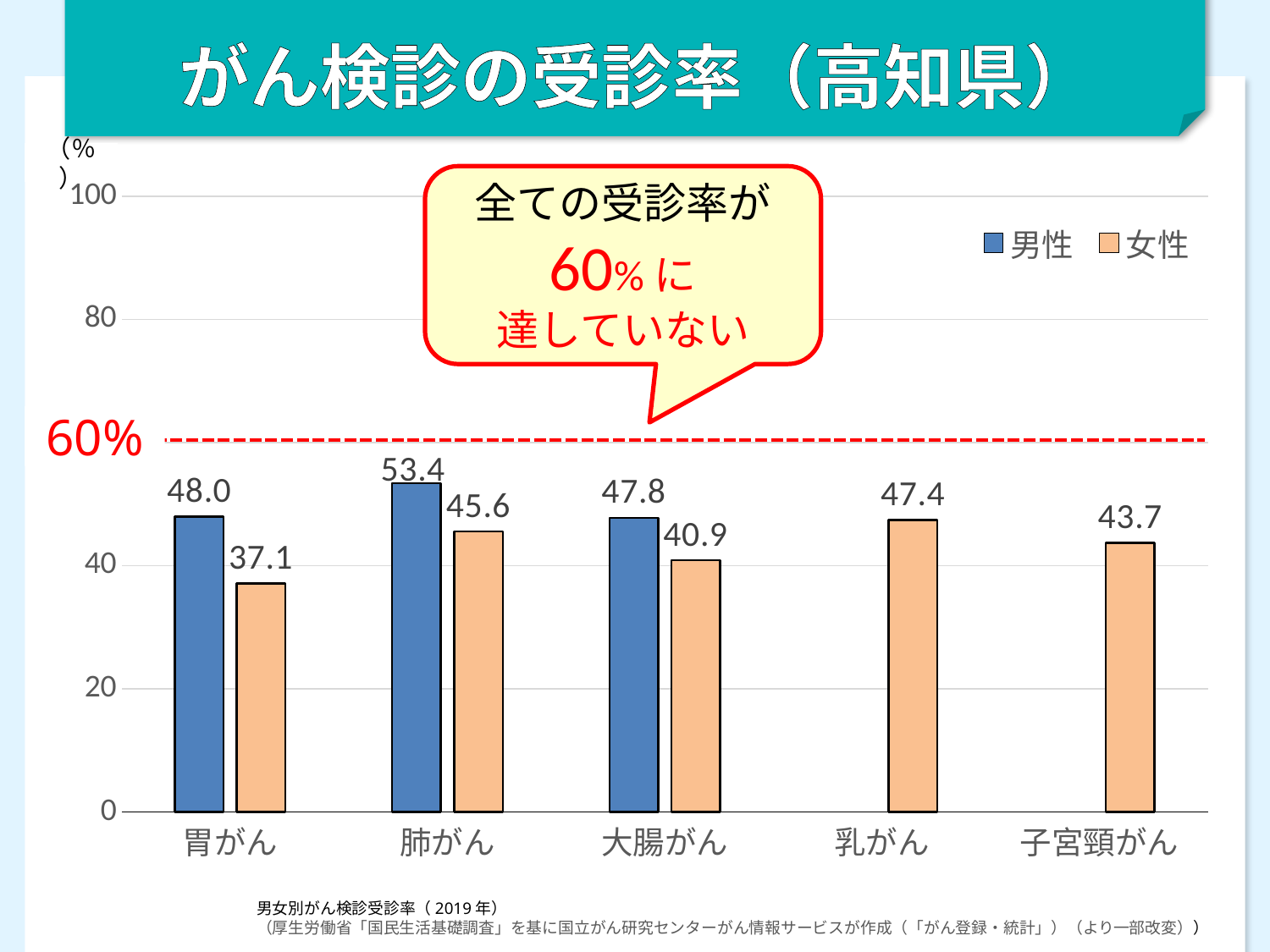
What is the screening rate for 男性 in the 胃がん category? 48.0 How many categories are shown on the x axis? 5 What is the value for 女性 in the 乳がん category? 47.4 What is the difference between the 男性 and 女性 values for 胃がん? 10.9 What is the screening rate for 女性 in the 肺がん category? 45.6 Which is larger for 大腸がん, the 男性 value or the 女性 value? 男性 What kind of chart is shown on the slide? bar chart How many series does the legend list? 2 Which category has the lowest 女性 screening rate? 胃がん Which category has the highest 男性 screening rate? 肺がん What is the value for 女性 in the 子宮頸がん category? 43.7 Is the 男性 value for 肺がん greater or less than 60? less